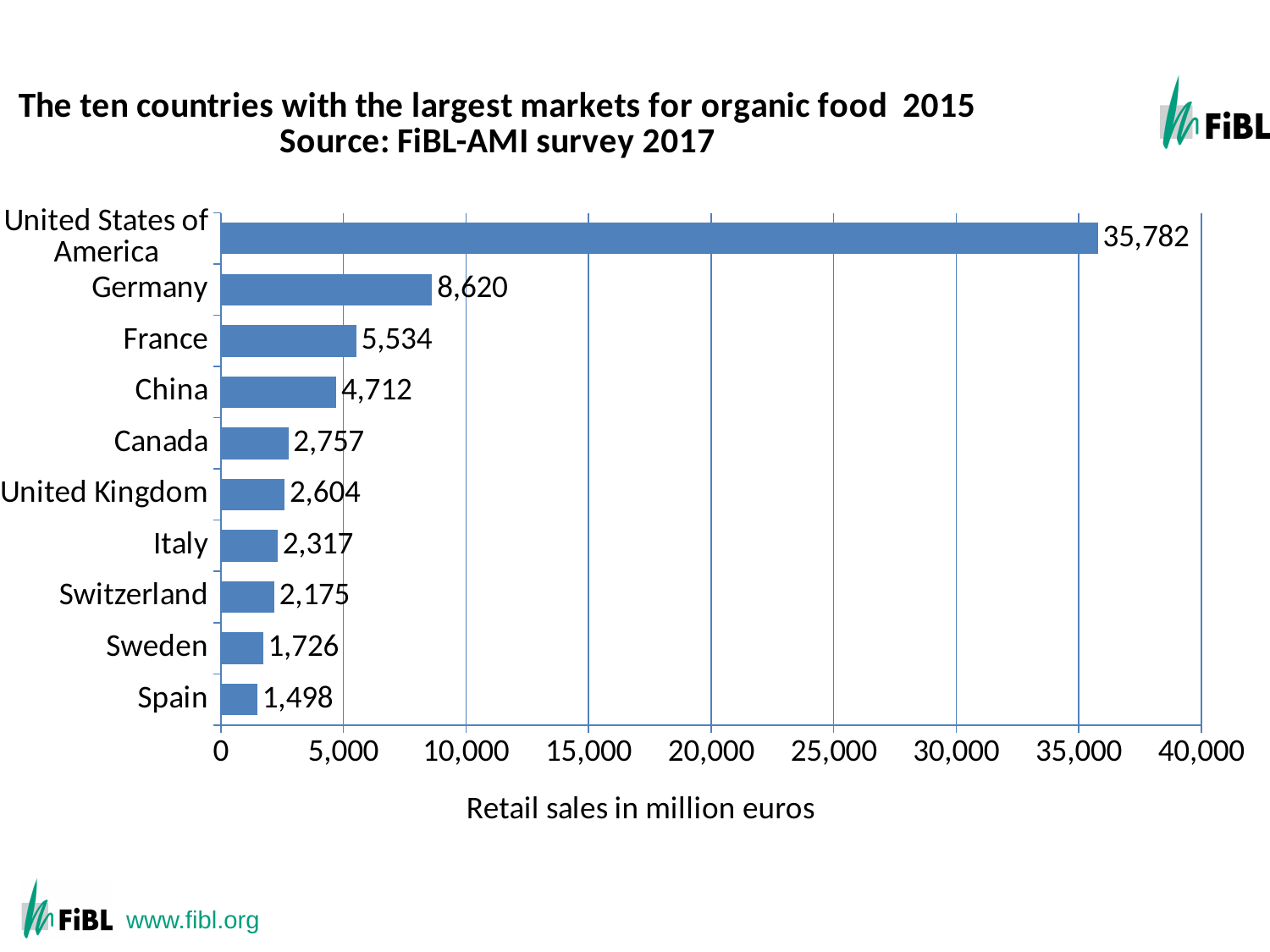
What is the difference between the values for France and China? 822 Which country has the smallest value shown on the chart? Spain How many countries are shown on the chart? 10 Which has a larger value, the United Kingdom or Italy? United Kingdom What kind of chart is shown on the slide? bar chart What is the retail sales value for Canada? 2,757 What is the retail sales value for Sweden? 1,726 Which country has the largest market for organic food? United States of America What is the label of the horizontal axis? Retail sales in million euros Is the value for Germany greater or less than 10,000? less What is the difference between the values for the United States of America and Germany? 27,162 What is the retail sales value for Germany? 8,620